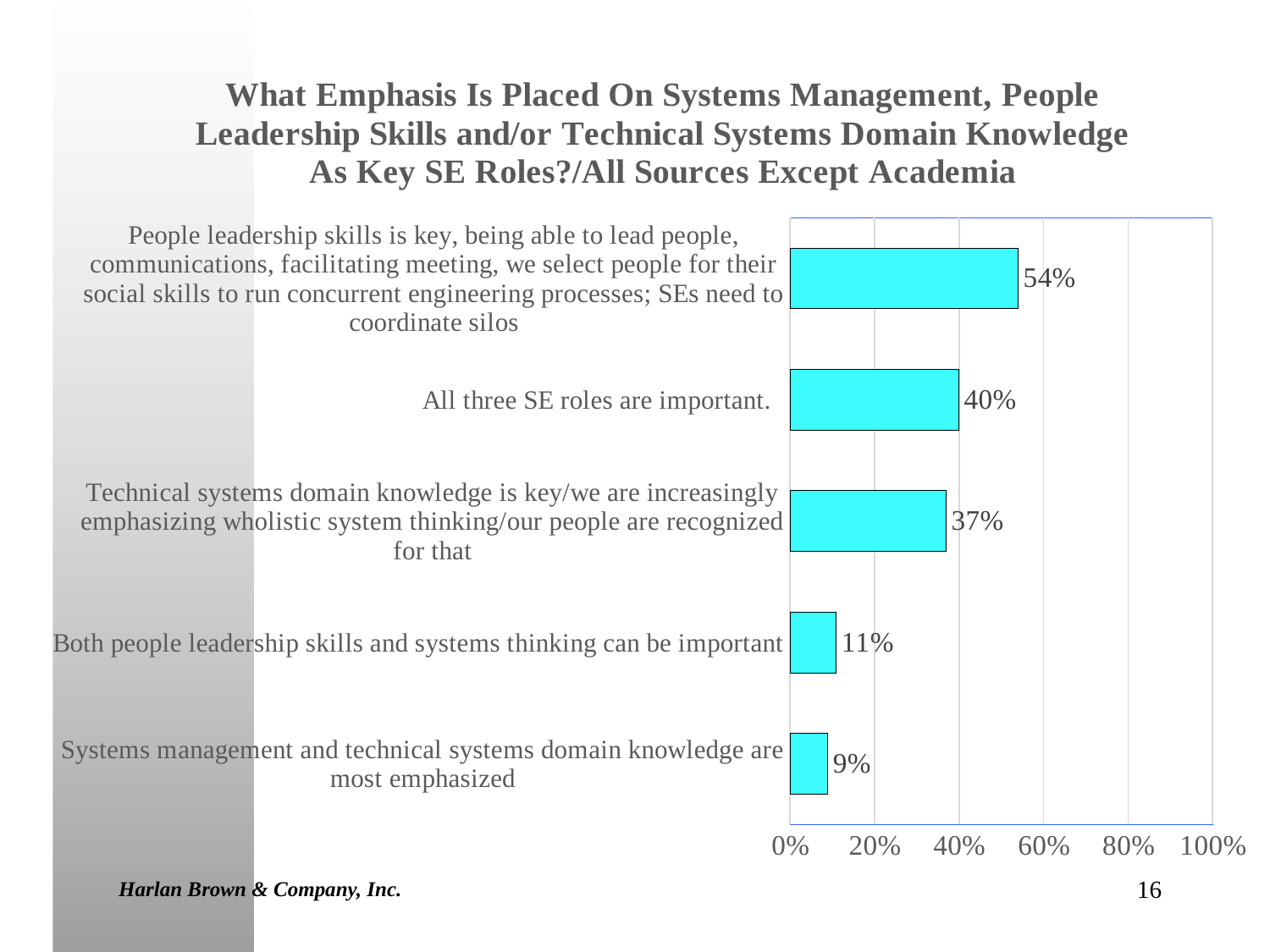
How many categories are shown on the chart? 5 What percentage is shown for "All three SE roles are important."? 40% What is the maximum value shown on the horizontal axis? 100% Is the value for the people leadership skills category greater or less than 60%? less What is the difference between the highest value and the lowest value on the chart? 45% What is the difference between the value for "All three SE roles are important." and the value for the technical systems domain knowledge category? 3% What is the value for "Both people leadership skills and systems thinking can be important"? 11% What is the value for "Systems management and technical systems domain knowledge are most emphasized"? 9% Which is larger: the value for "All three SE roles are important." or the value for "Both people leadership skills and systems thinking can be important"? All three SE roles are important. Which category has the lowest value? Systems management and technical systems domain knowledge are most emphasized What kind of chart is shown on the slide? bar chart